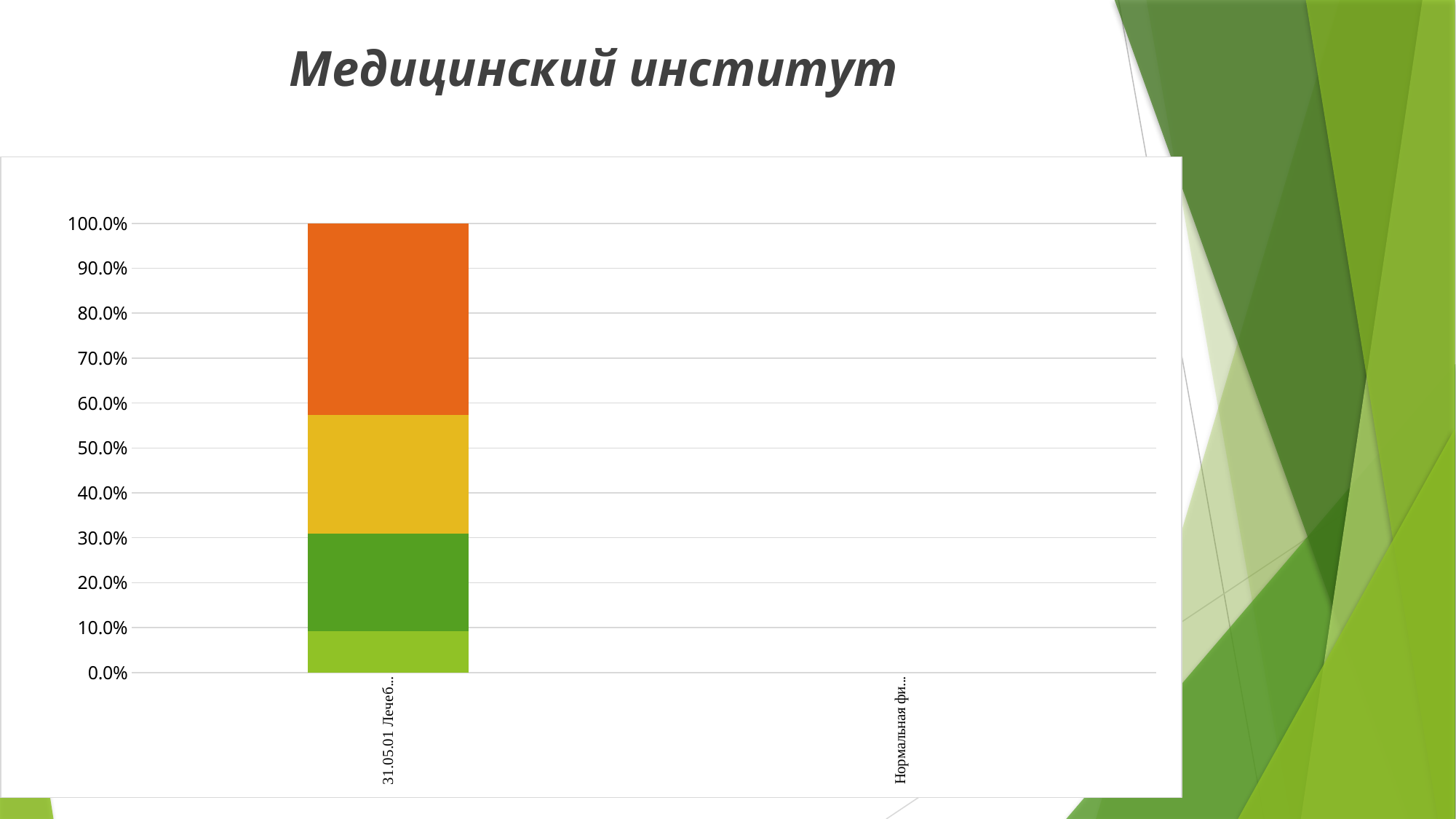
Which segment of the "31.05.01 Лечеб..." bar is the smallest: orange, yellow, dark green or light green? light green Is the top of the yellow segment in the "31.05.01 Лечеб..." bar greater or less than 60.0%? less Is the top of the light green segment in the "31.05.01 Лечеб..." bar greater or less than 20.0%? less Which segment of the "31.05.01 Лечеб..." bar is the largest: orange, yellow, dark green or light green? orange How many coloured segments make up the bar for "31.05.01 Лечеб..."? 4 Is the top of the dark green segment in the "31.05.01 Лечеб..." bar greater or less than 40.0%? less What is the total height of the stacked bar for "31.05.01 Лечеб..."? 100.0% What is the maximum value shown on the vertical axis of the chart? 100.0% What kind of chart is shown on the slide? stacked bar chart How many category labels are shown on the x axis of the chart? 2 What is the title of the slide? Медицинский институт